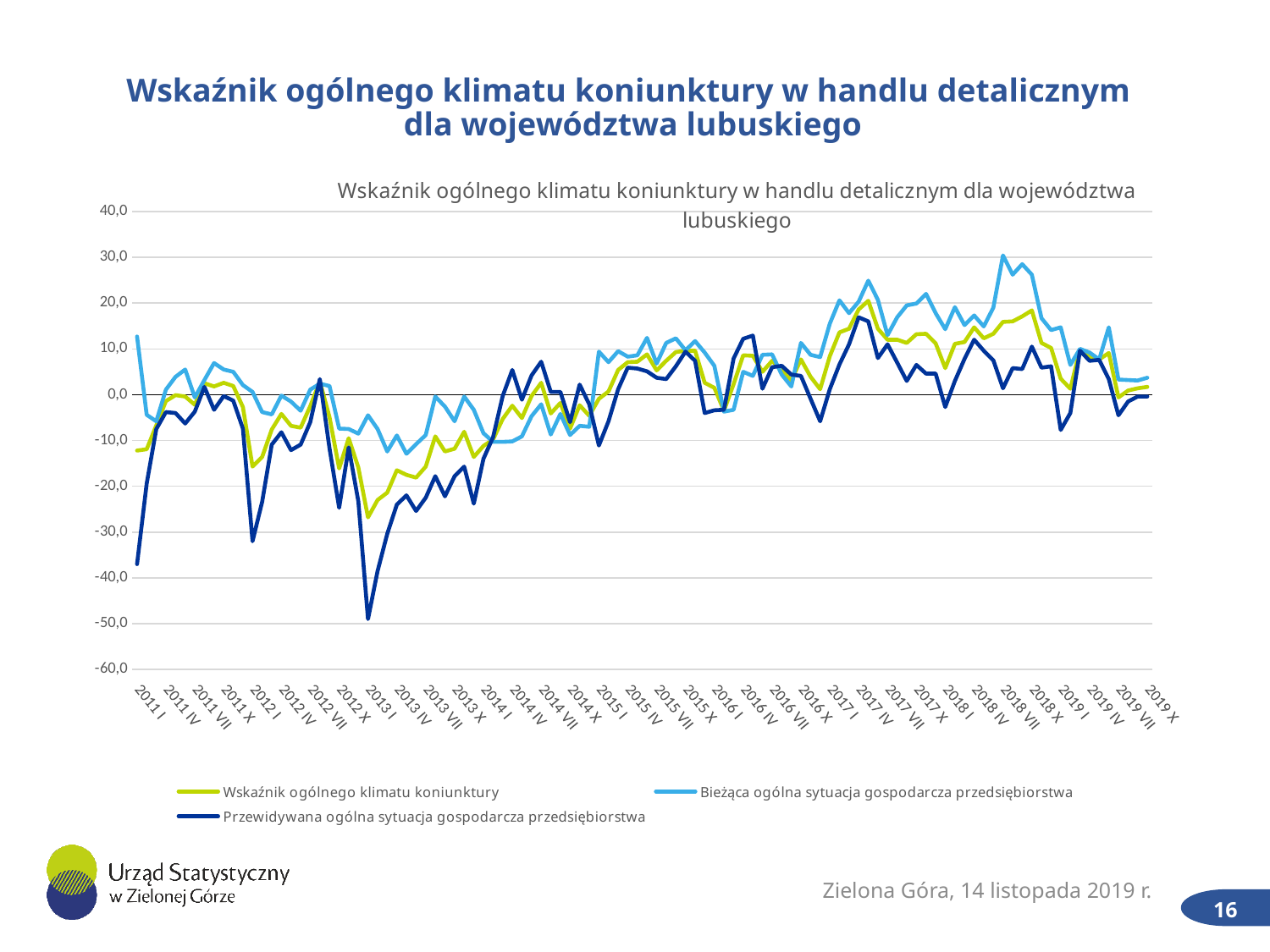
Is the value of Przewidywana ogólna sytuacja gospodarcza przedsiębiorstwa at 2011 I greater or less than -30? less Which series reaches the lowest value anywhere on the chart? Przewidywana ogólna sytuacja gospodarcza przedsiębiorstwa Is the value of Wskaźnik ogólnego klimatu koniunktury at 2013 I greater or less than -20? less Does the Wskaźnik ogólnego klimatu koniunktury line generally rise or fall between 2013 I and 2017 I? rise What kind of chart is shown on the slide? line chart Which series reaches the highest value anywhere on the chart? Bieżąca ogólna sytuacja gospodarcza przedsiębiorstwa At 2013 I, which is higher: Bieżąca ogólna sytuacja gospodarcza przedsiębiorstwa or Przewidywana ogólna sytuacja gospodarcza przedsiębiorstwa? Bieżąca ogólna sytuacja gospodarcza przedsiębiorstwa Is the value of Przewidywana ogólna sytuacja gospodarcza przedsiębiorstwa at 2013 I greater or less than -40? less What is the lowest value shown on the vertical axis? -60,0 How many series does the legend list? 3 Which series is drawn in green according to the legend? Wskaźnik ogólnego klimatu koniunktury